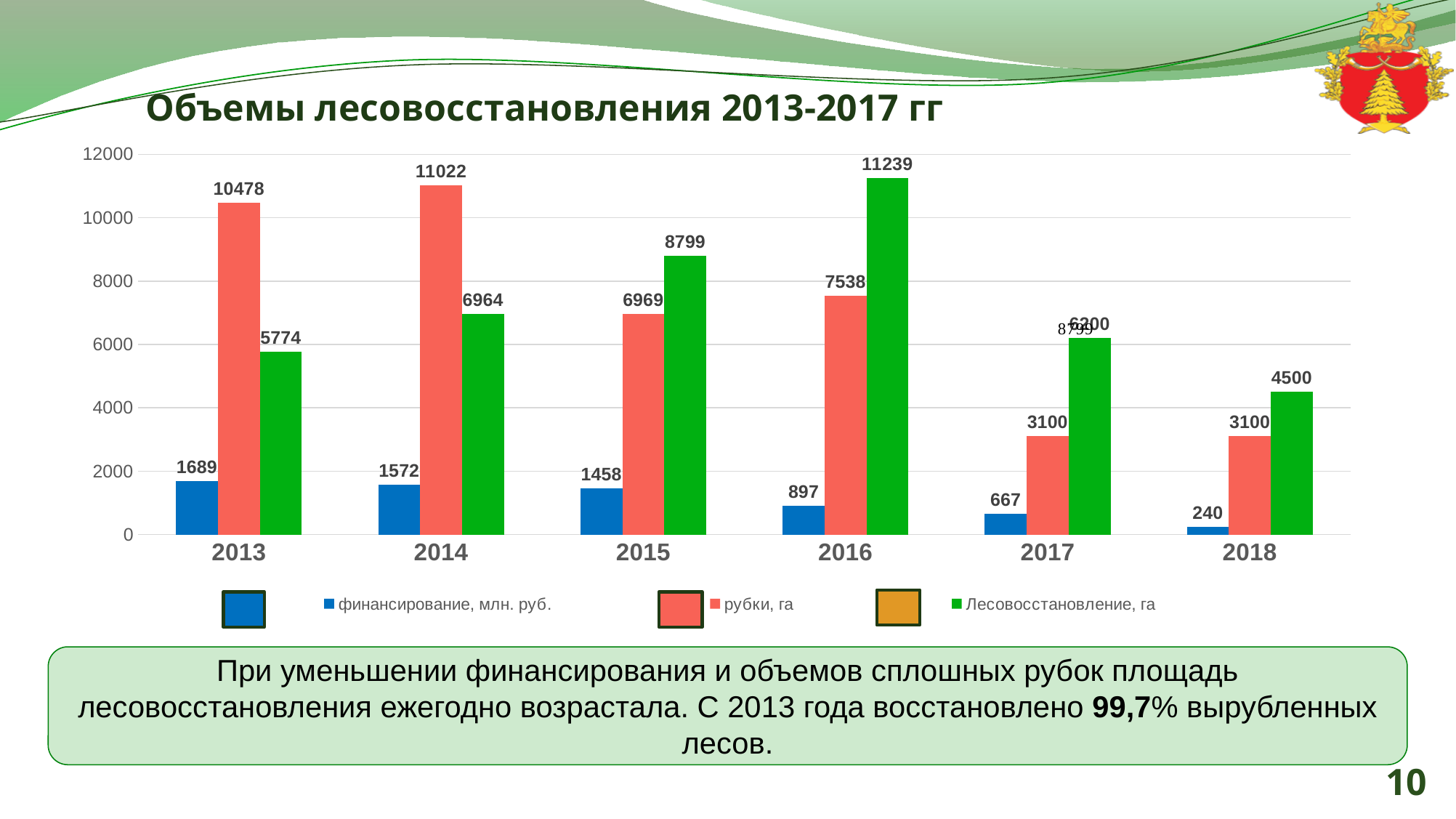
What is the value of рубки, га for 2014? 11022 What type of chart is shown on the slide? bar chart How many years are shown on the x axis? 6 What is the value of финансирование, млн. руб. for 2013? 1689 Which is larger in 2013: рубки, га or Лесовосстановление, га? рубки, га In which year is финансирование, млн. руб. the lowest? 2018 How many series does the legend list? 3 What is the difference between рубки, га and Лесовосстановление, га in 2015? 1830 What is the value of Лесовосстановление, га for 2016? 11239 In which year is Лесовосстановление, га the highest? 2016 What is the value of финансирование, млн. руб. for 2018? 240 Does финансирование, млн. руб. rise or fall from 2013 to 2018? fall